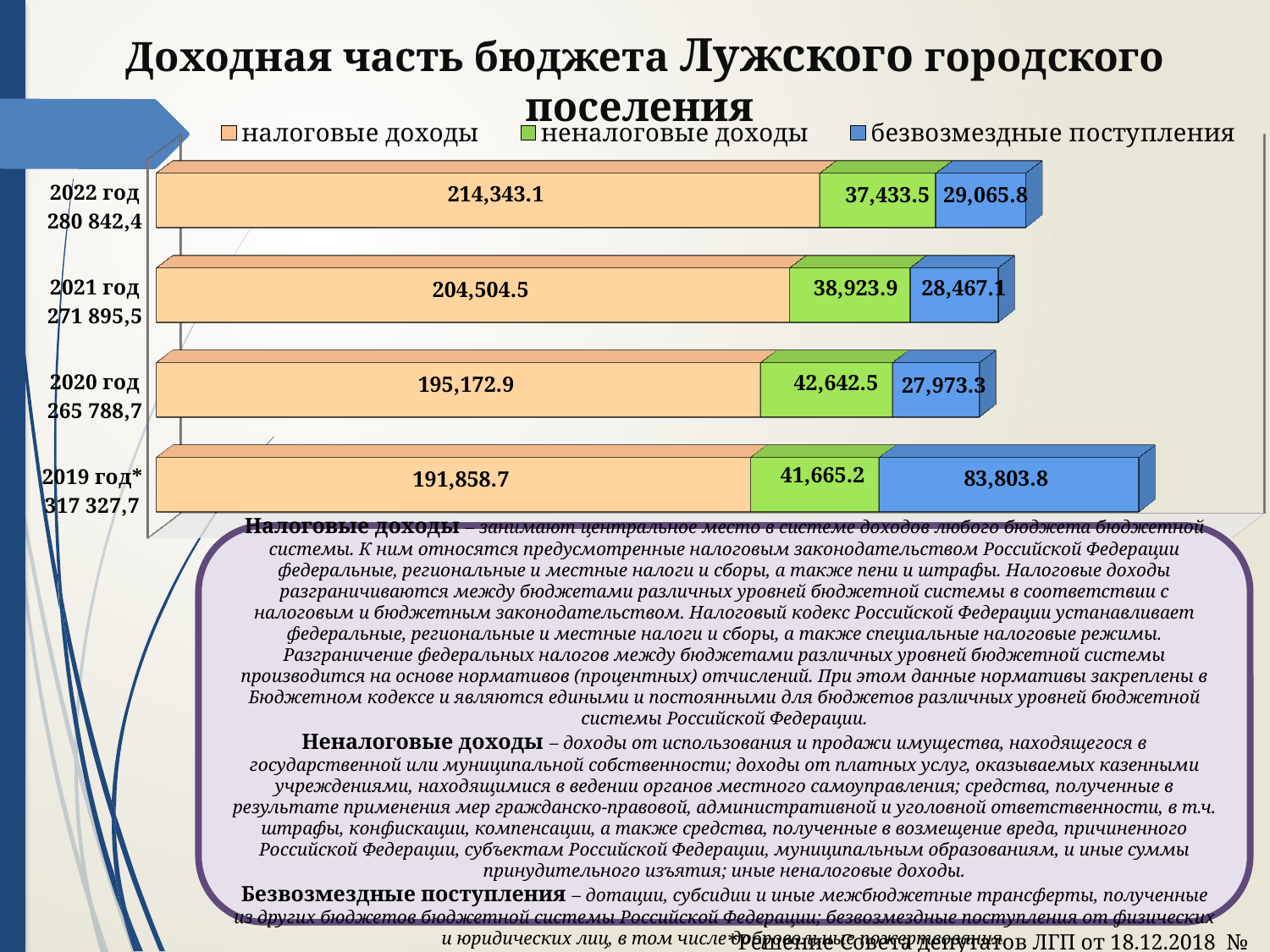
What is the value of безвозмездные поступления for 2021 год? 28,467.1 Which year has the lowest value of безвозмездные поступления? 2020 год What is the value of налоговые доходы for 2022 год? 214,343.1 Which year has the highest value of налоговые доходы? 2022 год What is the total shown for 2020 год? 265 788,7 Which is larger: неналоговые доходы in 2021 год or in 2019 год*? 2019 год* How many years (categories) are shown in the chart? 4 What is the value of неналоговые доходы for 2020 год? 42,642.5 What is the difference between налоговые доходы in 2022 год and 2021 год? 9,838.6 How many series does the legend list? 3 What type of chart is shown on the slide? Stacked bar chart What is the value of безвозмездные поступления for 2019 год*? 83,803.8